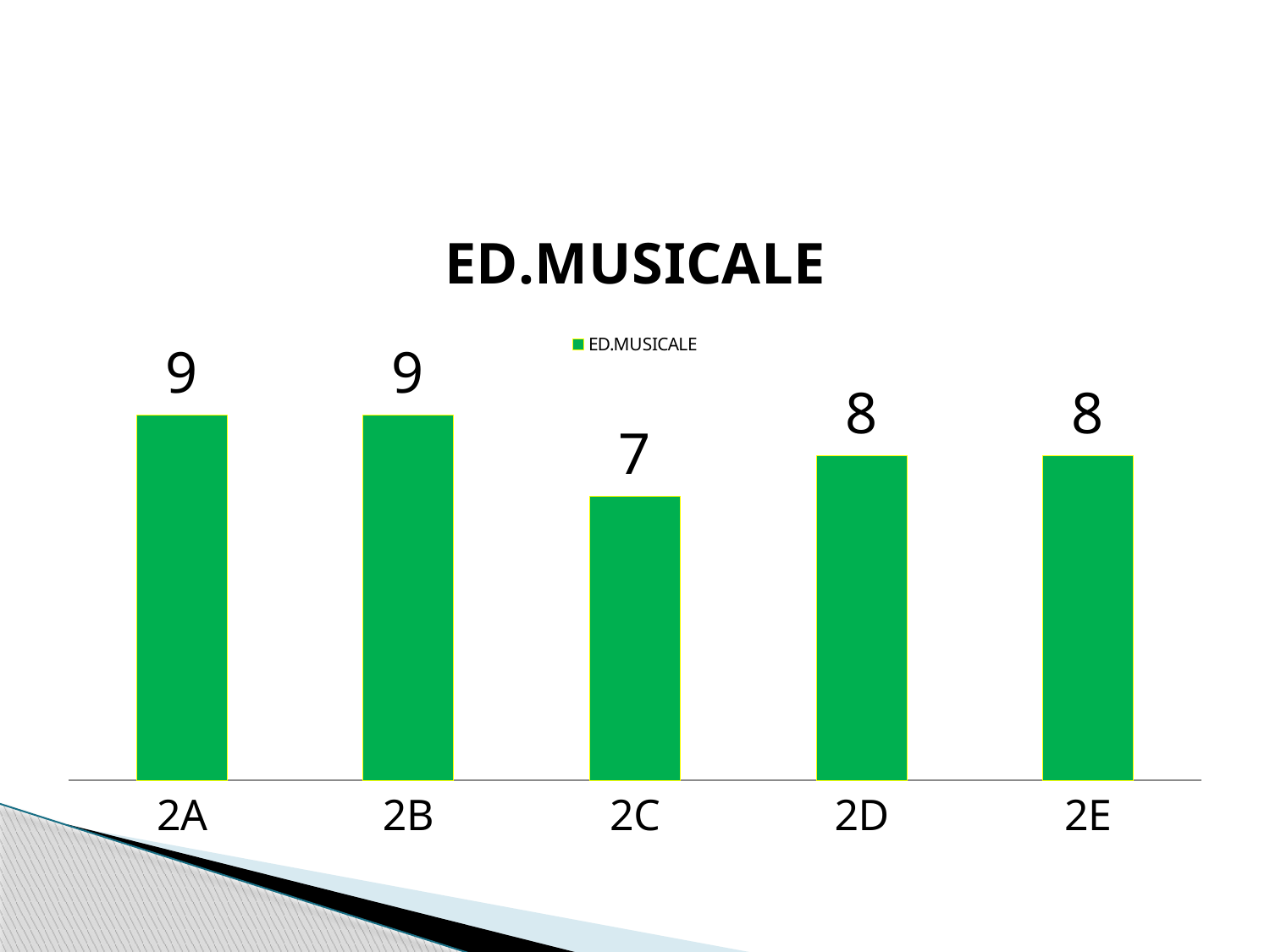
What kind of chart is shown? bar chart What is the value for 2E? 8 Which is larger, the value for 2B or the value for 2D? 2B How many categories are shown on the x axis? 5 What is the difference between the values for 2A and 2C? 2 What is the difference between the values for 2D and 2C? 1 What is the value for 2A? 9 What is the title of the chart? ED.MUSICALE What is the value for 2D? 8 How many series does the legend list? 1 Which category has the lowest value? 2C What is the value for 2C? 7